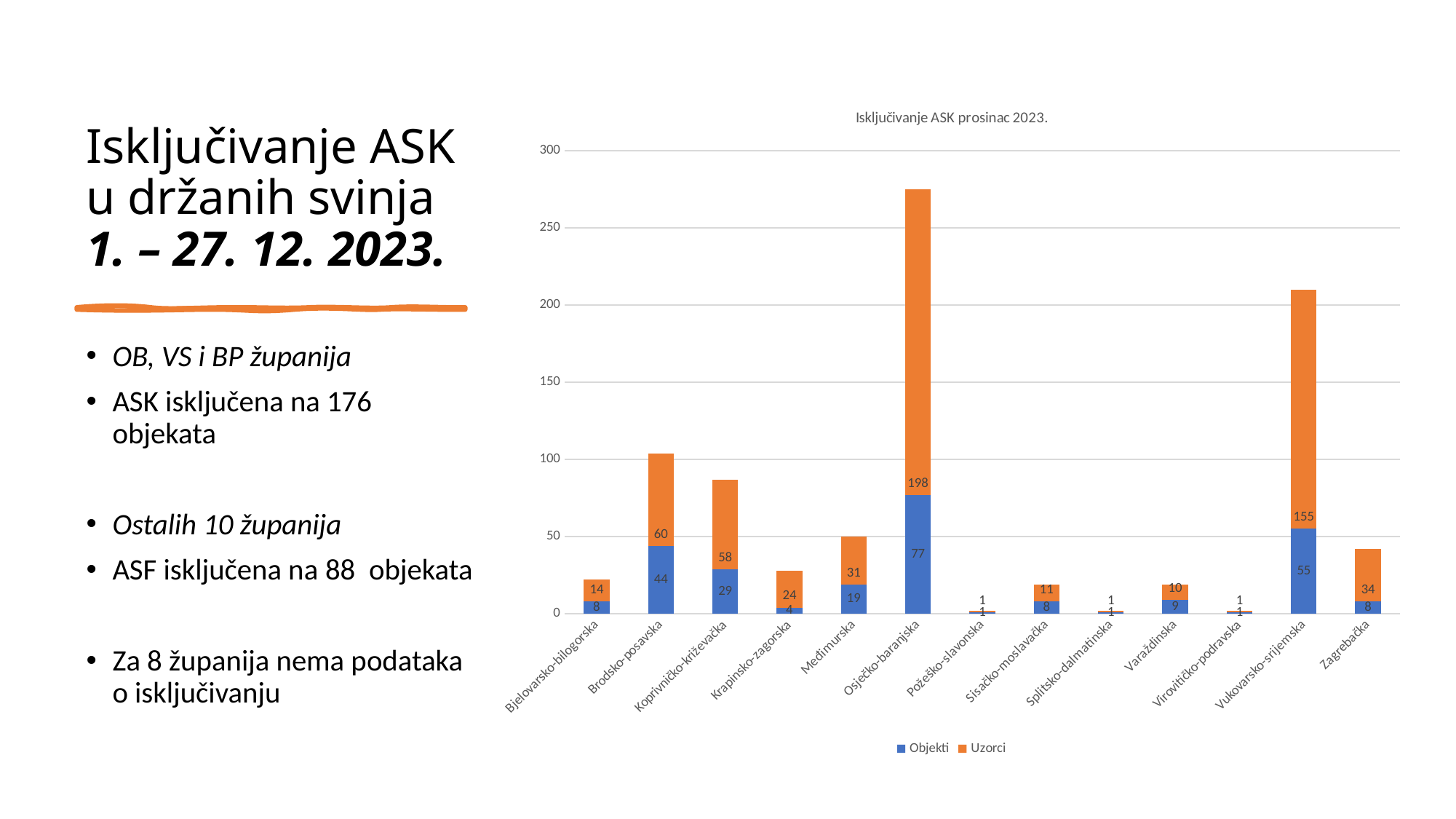
Which county has the highest Uzorci value? Osječko-baranjska What is the Objekti value for Vukovarsko-srijemska? 55 What is the total of the stacked bar for Brodsko-posavska? 104 What is the title of the chart? Isključivanje ASK prosinac 2023. What is the Uzorci value for Osječko-baranjska? 198 What type of chart is shown on the slide? stacked bar chart How many counties (categories) are shown on the x axis? 13 How many series does the legend list? 2 Which county has the lowest Objekti value among Krapinsko-zagorska, Međimurska and Zagrebačka? Krapinsko-zagorska What is the difference between the Uzorci values for Osječko-baranjska and Vukovarsko-srijemska? 43 What is the Objekti value for Brodsko-posavska? 44 Which is larger: the Objekti value for Koprivničko-križevačka or for Međimurska? Koprivničko-križevačka